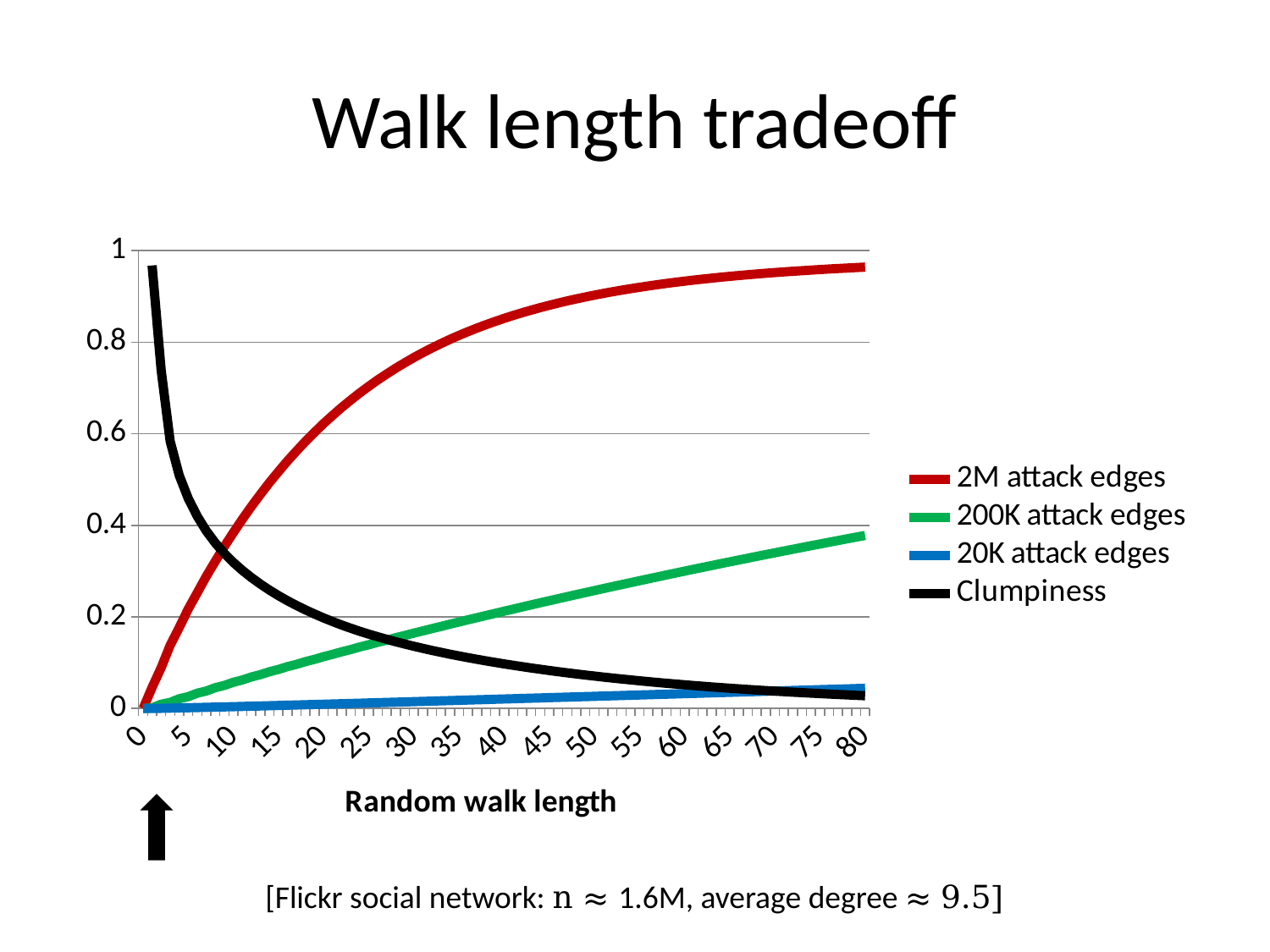
What is the title of the chart? Walk length tradeoff Does the 2M attack edges series rise or fall as random walk length increases? rise At random walk length 80, which series has the highest value? 2M attack edges What kind of chart is shown on the slide? line chart Is the value for Clumpiness at random walk length 40 greater or less than 0.2? less How many series does the legend list? 4 At random walk length 5, which is larger: Clumpiness or 2M attack edges? Clumpiness Is the value for 200K attack edges at random walk length 80 greater or less than 0.2? greater Does the Clumpiness series rise or fall as random walk length increases? fall Is the value for 2M attack edges at random walk length 80 greater or less than 0.8? greater Does the 200K attack edges series rise or fall as random walk length increases? rise What is the label of the x axis? Random walk length